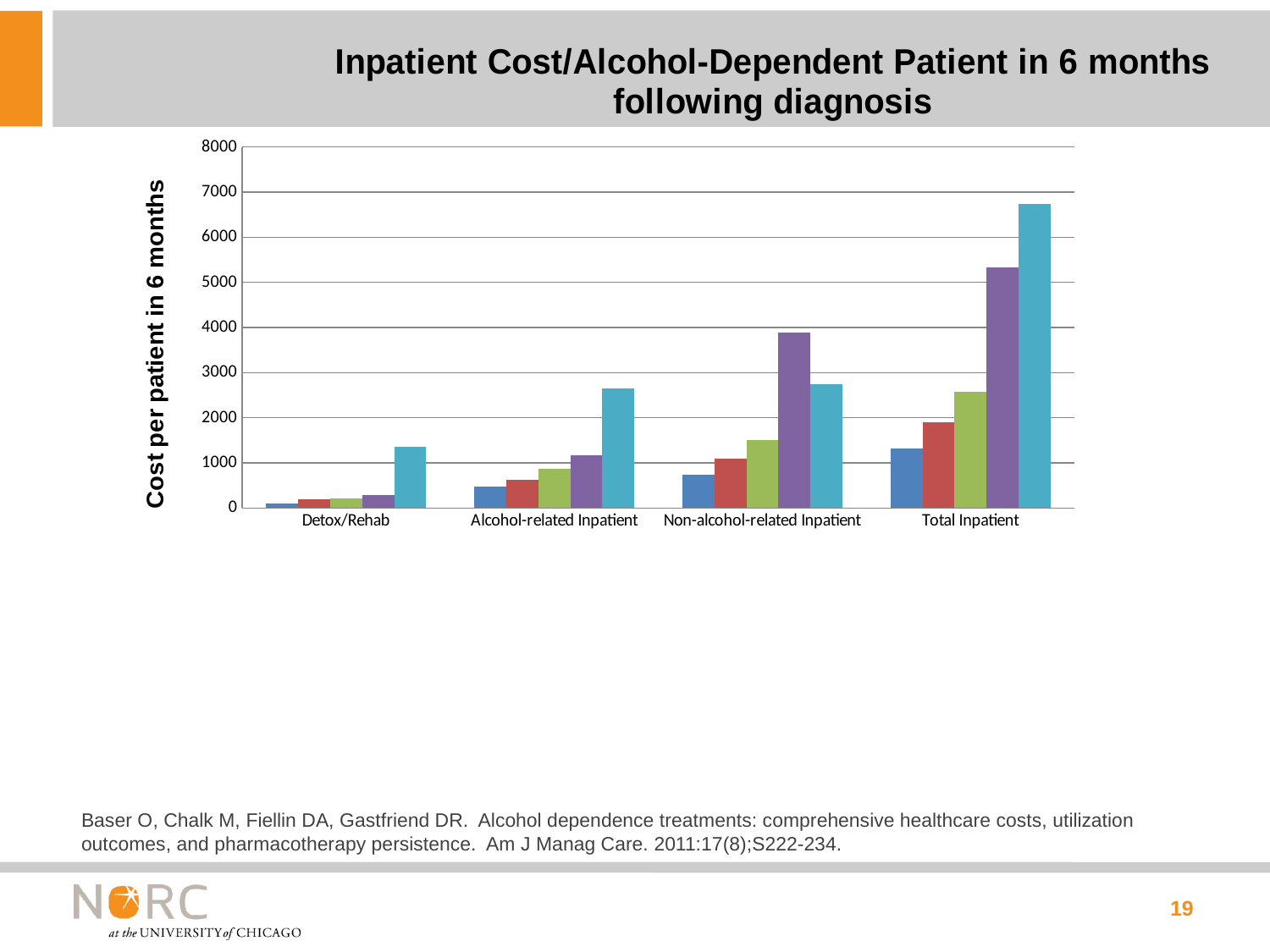
Which category has the lowest bars overall in the chart? Detox/Rehab How many categories are shown on the x axis of the chart? 4 Is the value of the teal (rightmost) bar for Total Inpatient greater or less than 6000? greater How many bars are plotted for each category in the chart? 5 Is the value of the purple bar for Total Inpatient greater or less than 5000? greater What kind of chart is shown on the slide? bar chart Do the bar values generally rise or fall moving from Detox/Rehab to Total Inpatient along the x axis? rise Is the value of the teal (rightmost) bar for Detox/Rehab greater or less than 1000? greater For Non-alcohol-related Inpatient, which bar is taller: the purple bar or the teal bar? the purple bar Which category has the tallest bar in the chart? Total Inpatient What is the label on the y axis of the chart? Cost per patient in 6 months